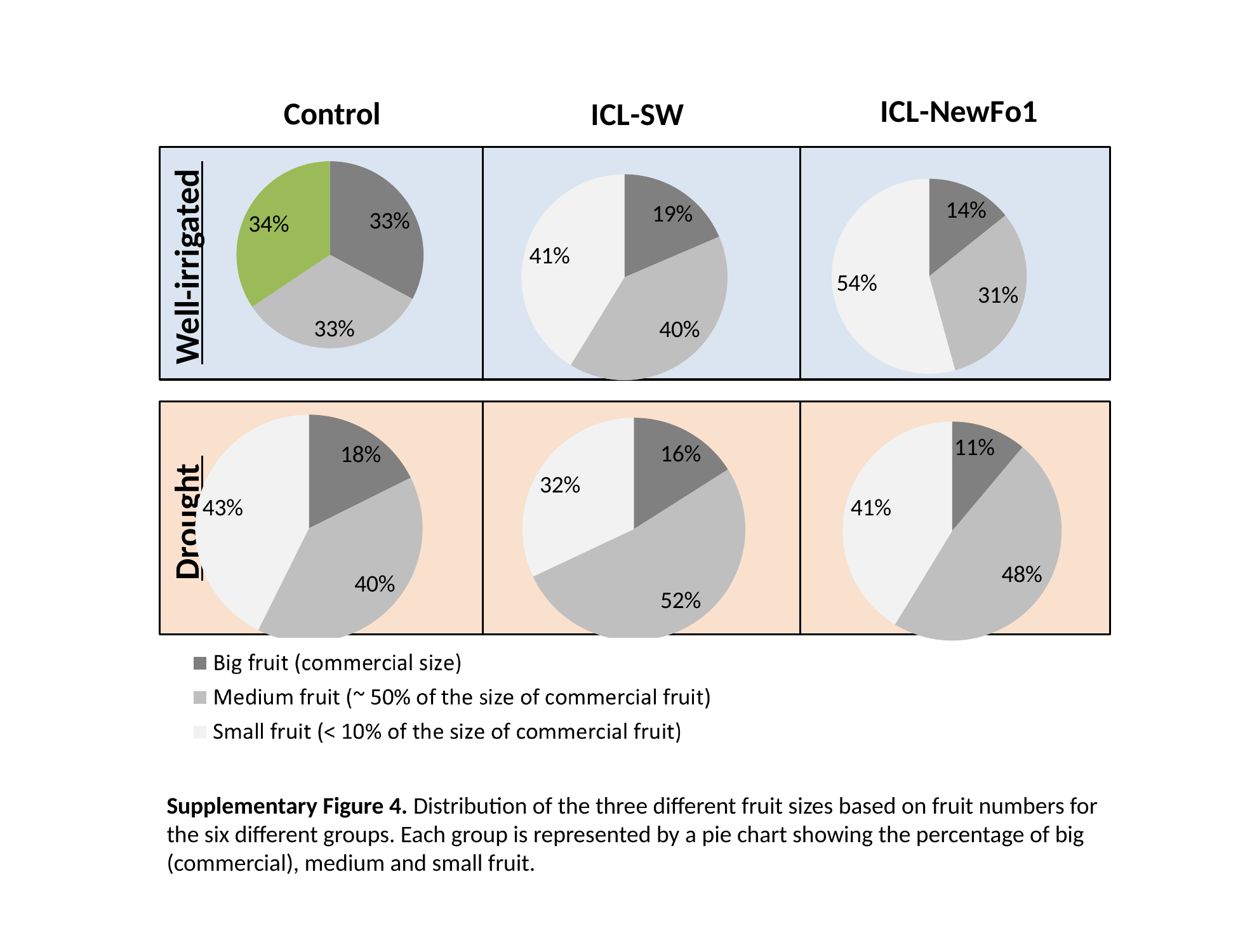
In the Drought ICL-SW pie chart, what percentage is medium fruit? 52% How many pie charts are shown on the slide? 6 In the Well-irrigated ICL-SW pie chart, what percentage is big fruit (commercial size)? 19% Which is larger: the medium fruit share in the Drought ICL-SW pie chart or the medium fruit share in the Drought ICL-NewFo1 pie chart? Drought ICL-SW In the Well-irrigated Control pie chart, what percentage is shown on the green slice? 34% In the Well-irrigated ICL-NewFo1 pie chart, what percentage is small fruit? 54% What kind of charts are shown on the slide? Pie charts In the Drought ICL-NewFo1 pie chart, what percentage is big fruit (commercial size)? 11% In the Drought Control pie chart, which fruit size category has the largest share? Small fruit How many fruit size categories does the legend list? 3 In the Well-irrigated ICL-NewFo1 pie chart, which fruit size category has the smallest share? Big fruit (commercial size) What is the difference between the big fruit share in the Well-irrigated Control pie chart and the big fruit share in the Drought Control pie chart? 15%